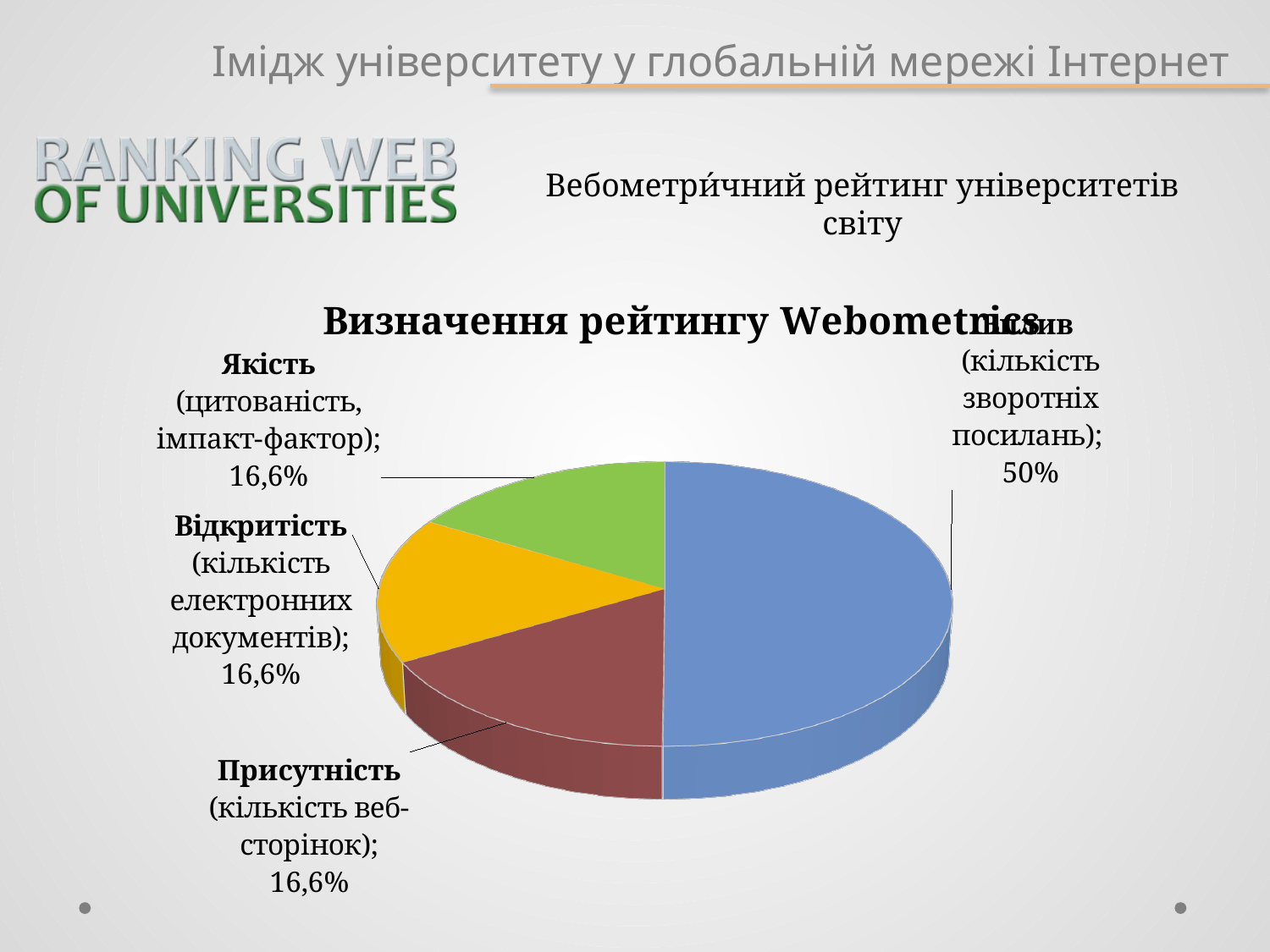
What kind of chart is shown on the slide? Pie chart What is the difference between the share for Вплив and the share for Якість? 33,4% What is the share for Вплив (кількість зворотніх посилань)? 50% How many slices does the pie chart have? 4 What is the share for Відкритість (кількість електронних документів)? 16,6% Which is larger, the share for Вплив or the share for Присутність? Вплив Which category has the largest slice of the pie? Вплив What is the share for Якість (цитованість, імпакт-фактор)? 16,6% What is the title of the pie chart? Визначення рейтингу Webometrics What colour is the slice for Вплив? Blue What is the share for Присутність (кількість веб-сторінок)? 16,6%